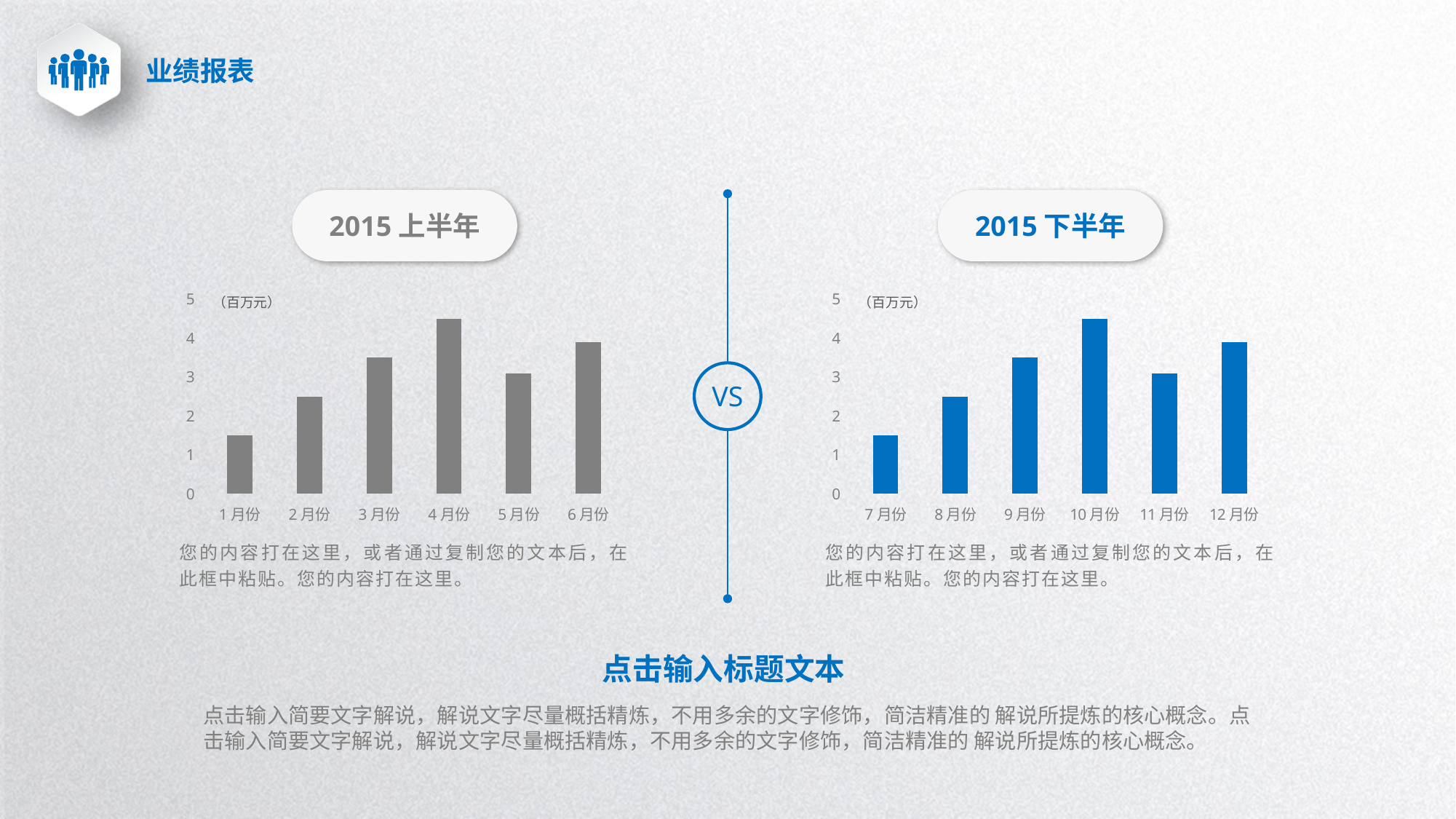
What kind of chart is the 2015 上半年 chart? bar chart In the 2015 上半年 chart, is the value for 4月份 greater or less than 4? greater In the 2015 下半年 chart, which month has the lowest bar? 7月份 What unit is shown on the y axis of the 2015 下半年 chart? 百万元 How many months are shown on the 2015 上半年 chart? 6 In the 2015 上半年 chart, which month has the lowest bar? 1月份 In the 2015 上半年 chart, which is larger, the value for 6月份 or the value for 5月份? 6月份 In the 2015 下半年 chart, is the value for 7月份 greater or less than 2? less In the 2015 下半年 chart, which is larger, the value for 8月份 or the value for 9月份? 9月份 In the 2015 下半年 chart, which month has the highest bar? 10月份 In the 2015 上半年 chart, which month has the highest bar? 4月份 How many months are shown on the 2015 下半年 chart? 6